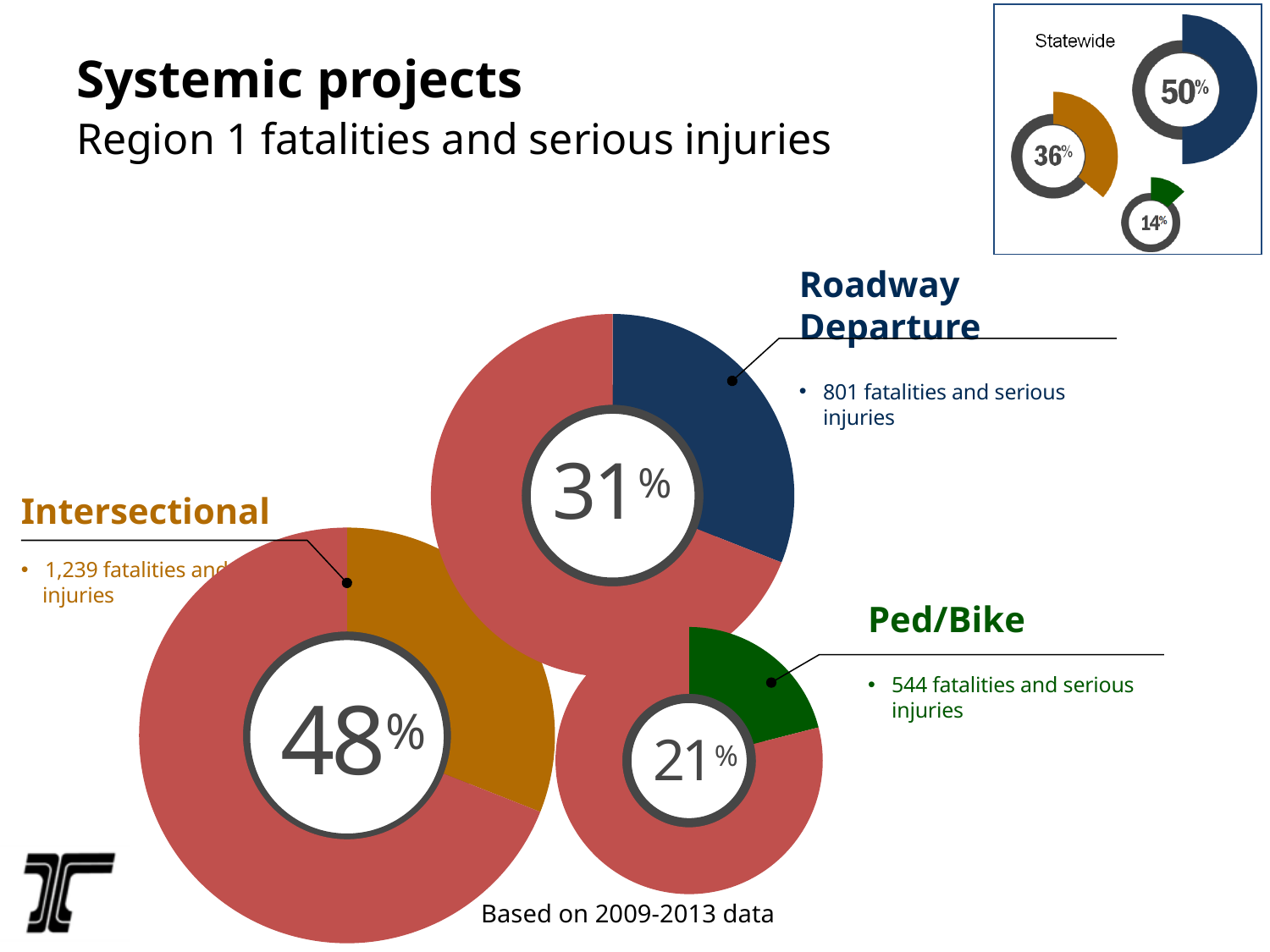
What percentage is shown in the Ped/Bike donut chart? 21% In the Statewide inset, what percentage is shown in the dark blue donut chart? 50% How many fatalities and serious injuries are listed for Roadway Departure? 801 Which is larger, the Roadway Departure percentage or the Ped/Bike percentage? Roadway Departure What kind of chart is used to show the Region 1 percentages? Donut (pie) chart What percentage is shown in the Roadway Departure donut chart? 31% What percentage is shown in the Intersectional donut chart? 48% How many fatalities and serious injuries are listed for Ped/Bike? 544 Which of the three Region 1 categories has the lowest percentage? Ped/Bike How many Region 1 donut charts are shown on the slide (excluding the Statewide inset)? 3 Which of the three Region 1 categories has the highest percentage? Intersectional What is the difference in percentage points between the Intersectional and Ped/Bike donut charts? 27